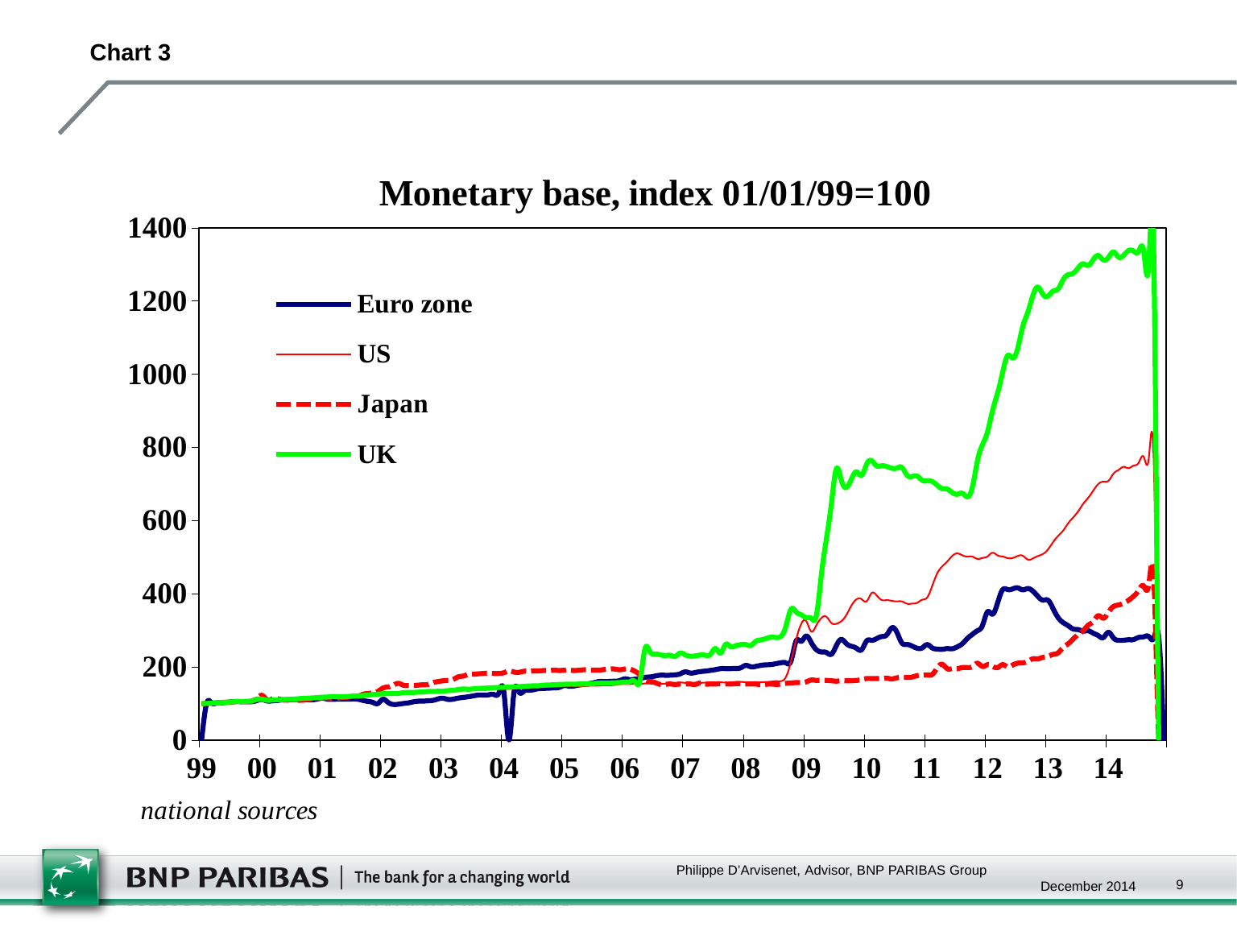
Does the UK series generally rise or fall from 99 to 14? rise What is the title of the chart? Monetary base, index 01/01/99=100 Is the value for Japan in 2005 greater or less than 400? less Which series is lowest in 2010? Japan Is the value for US in 2014 greater or less than 600? greater How many series does the legend list? 4 Which series reaches the highest value on the chart? UK In 2010, which is larger, the value for US or the value for Japan? US What type of chart is shown on the slide? line chart Is the value for UK in 2013 greater or less than 1000? greater In 2013, which is larger, the value for UK or the value for Euro zone? UK